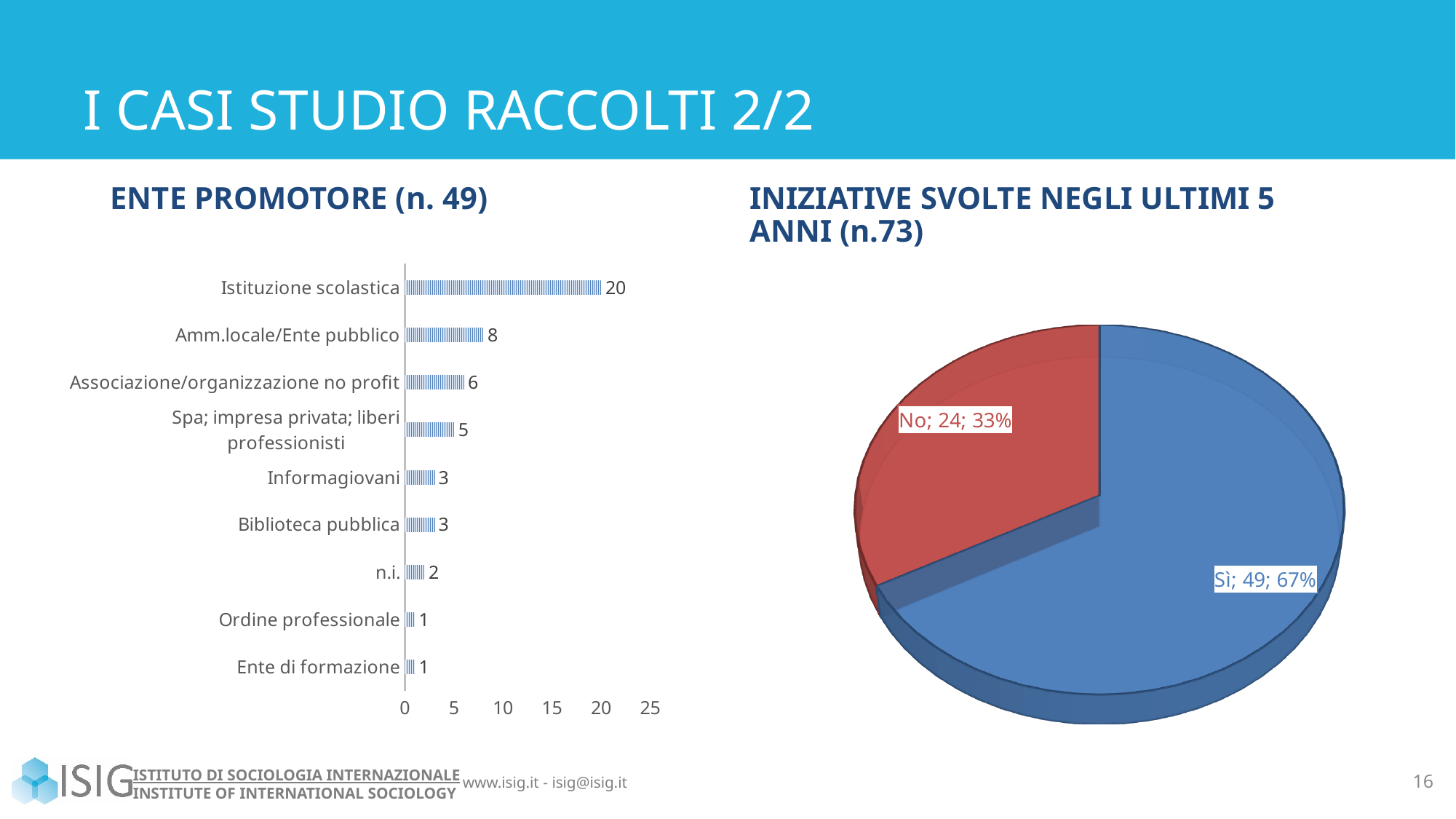
What kind of chart is the 'INIZIATIVE SVOLTE NEGLI ULTIMI 5 ANNI (n.73)' chart? pie chart In the 'ENTE PROMOTORE (n. 49)' chart, which is larger: Associazione/organizzazione no profit or Informagiovani? Associazione/organizzazione no profit In the 'INIZIATIVE SVOLTE NEGLI ULTIMI 5 ANNI (n.73)' chart, what is the value for 'No'? 24 In the 'ENTE PROMOTORE (n. 49)' chart, what is the value for n.i.? 2 In the 'ENTE PROMOTORE (n. 49)' chart, which category has the highest value? Istituzione scolastica In the 'INIZIATIVE SVOLTE NEGLI ULTIMI 5 ANNI (n.73)' chart, what colour is the 'No' slice? red What kind of chart is the 'ENTE PROMOTORE (n. 49)' chart? bar chart In the 'ENTE PROMOTORE (n. 49)' chart, what is the value for Istituzione scolastica? 20 In the 'ENTE PROMOTORE (n. 49)' chart, what is the value for Amm.locale/Ente pubblico? 8 How many categories are shown in the 'ENTE PROMOTORE (n. 49)' chart? 9 In the 'INIZIATIVE SVOLTE NEGLI ULTIMI 5 ANNI (n.73)' chart, what share of the pie is the 'Sì' slice? 67% In the 'ENTE PROMOTORE (n. 49)' chart, what is the difference between Istituzione scolastica and Amm.locale/Ente pubblico? 12